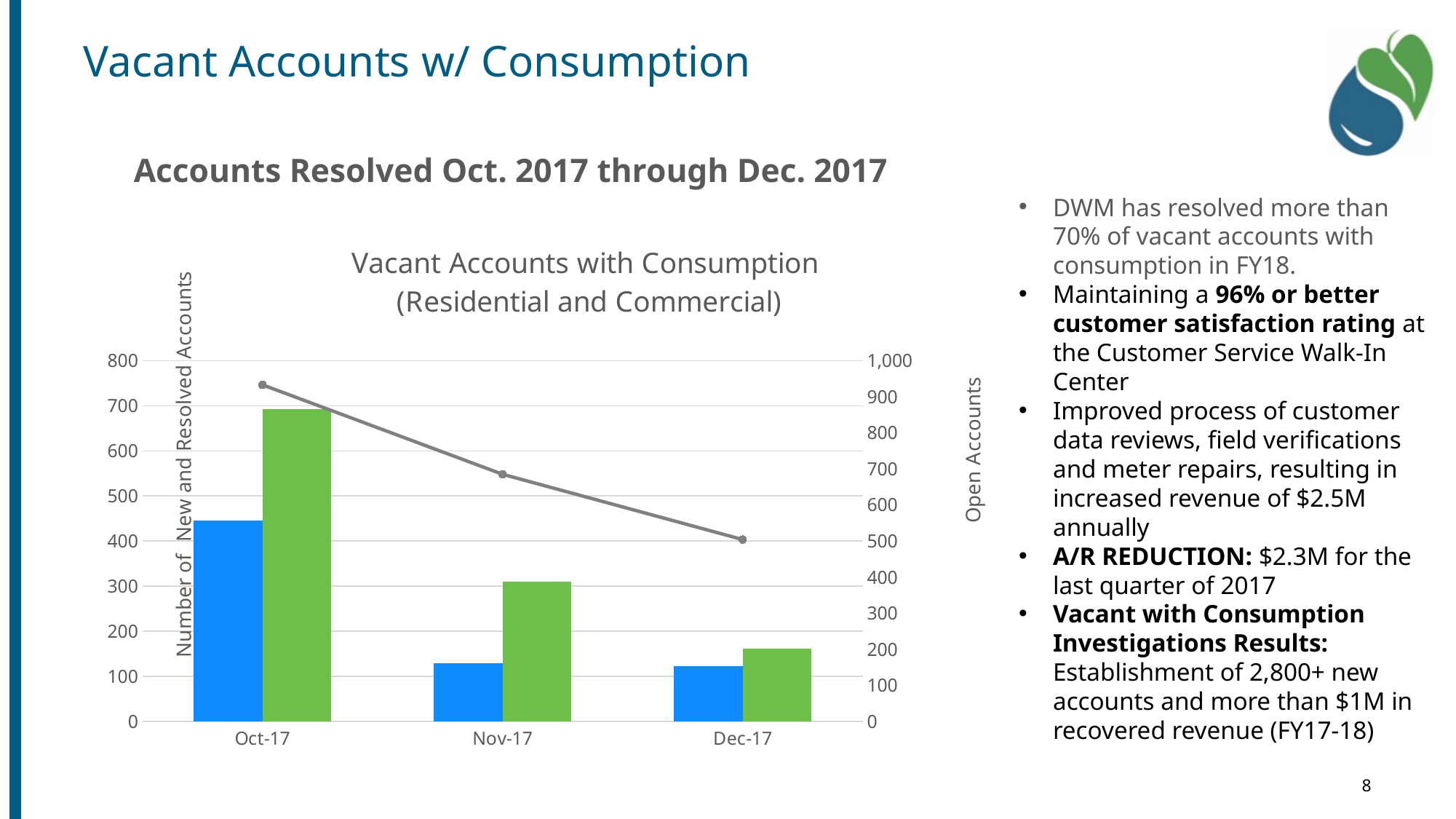
How many categories are shown on the x axis of the chart? 3 Which month has the highest green bar? Oct-17 Is the green bar for Oct-17 greater or less than 600 on the left axis? greater Which month has the lowest green bar? Dec-17 Is the blue bar for Nov-17 greater or less than 200 on the left axis? less Does the grey line rise or fall from Oct-17 to Dec-17? Falls What is the title of the chart? Vacant Accounts with Consumption (Residential and Commercial) Is the grey line value for Dec-17 greater or less than 600 on the right axis? less What kind of chart is shown on the slide? Combined bar and line chart What is the label of the right-hand vertical axis? Open Accounts